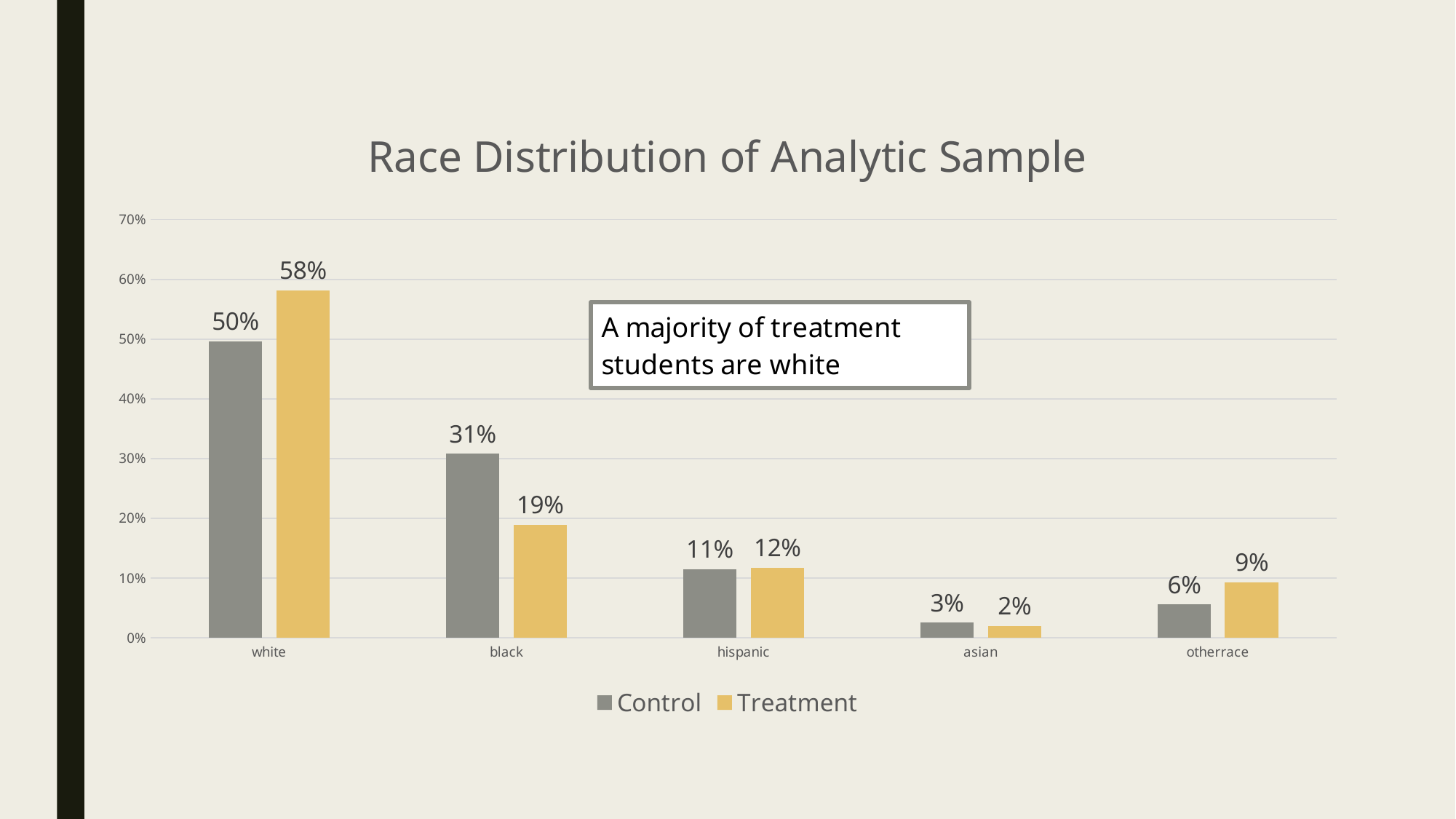
How many categories are shown on the x axis? 5 What is the Control value for black? 31% Which category has the highest Control value? white What kind of chart is shown on the slide? bar chart What is the difference between the Control and Treatment values for black? 12% Which is larger for hispanic, the Control value or the Treatment value? Treatment Is the Control value for white greater or less than 40%? greater Which category has the lowest Treatment value? asian How many series does the legend list? 2 What is the Treatment value for otherrace? 9% What is the Treatment value for white? 58% What is the title of the chart? Race Distribution of Analytic Sample